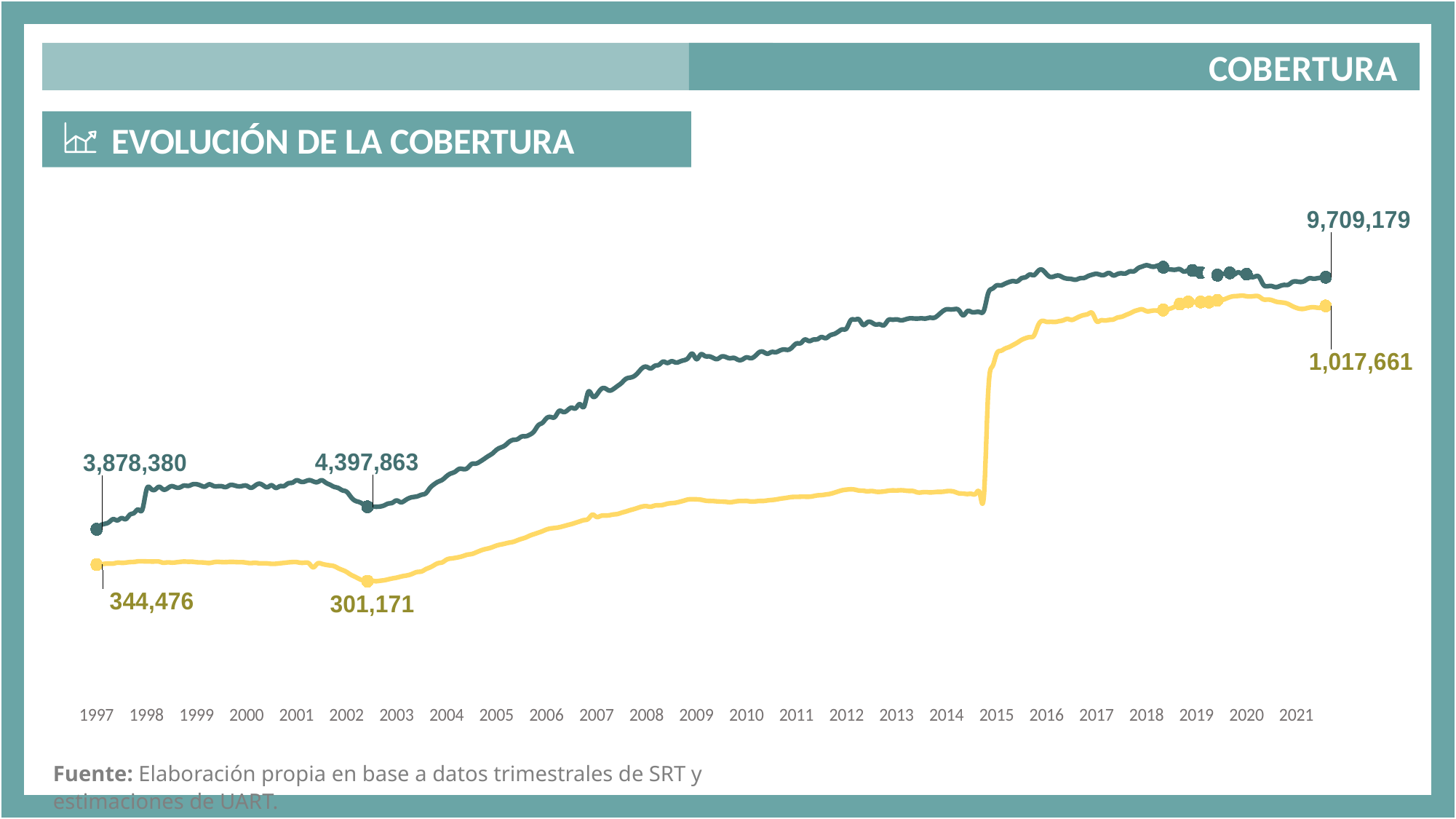
What is the labelled value of the yellow line at its starting point in 1997? 344,476 What is the labelled value of the dark teal line at its dip around 2002? 4,397,863 What is the labelled value of the dark teal line at its final point in 2021? 9,709,179 How many year labels are shown on the x axis? 25 By how much did the dark teal line increase from its 1997 label (3,878,380) to its 2021 label (9,709,179)? 5,830,799 What is the labelled value of the yellow line at its final point in 2021? 1,017,661 What is the difference between the yellow line's 1997 label (344,476) and its 2002 label (301,171)? 43,305 What is the labelled value of the dark teal line at its starting point in 1997? 3,878,380 What kind of chart is shown on the slide? line chart Which line has higher values throughout the chart, the dark teal line or the yellow line? the dark teal line What is the labelled value of the yellow line at its low point around 2002? 301,171 What is the title of the chart? EVOLUCIÓN DE LA COBERTURA